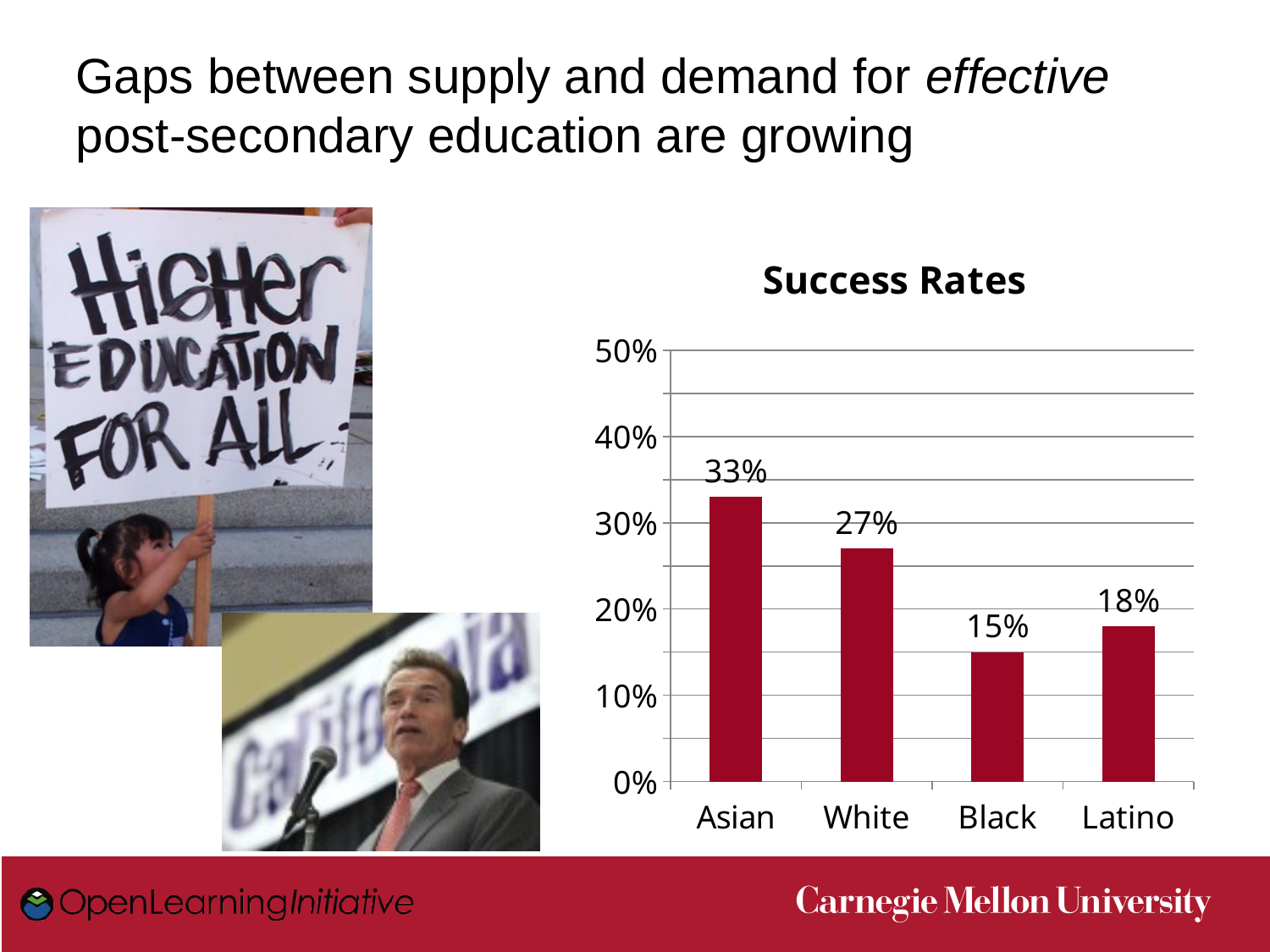
What is the difference between the success rates for Latino and Black students? 3% What is the difference between the success rates for Asian and White students? 6% What is the success rate for White students? 27% What is the success rate for Black students? 15% What is the success rate for Latino students? 18% How many categories are shown in the chart? 4 Which category has the lowest success rate? Black Which has a higher success rate, White or Latino? White Is the success rate for Asian students greater or less than 30%? greater What is the success rate for Asian students? 33% What is the title of the chart? Success Rates Which category has the highest success rate? Asian